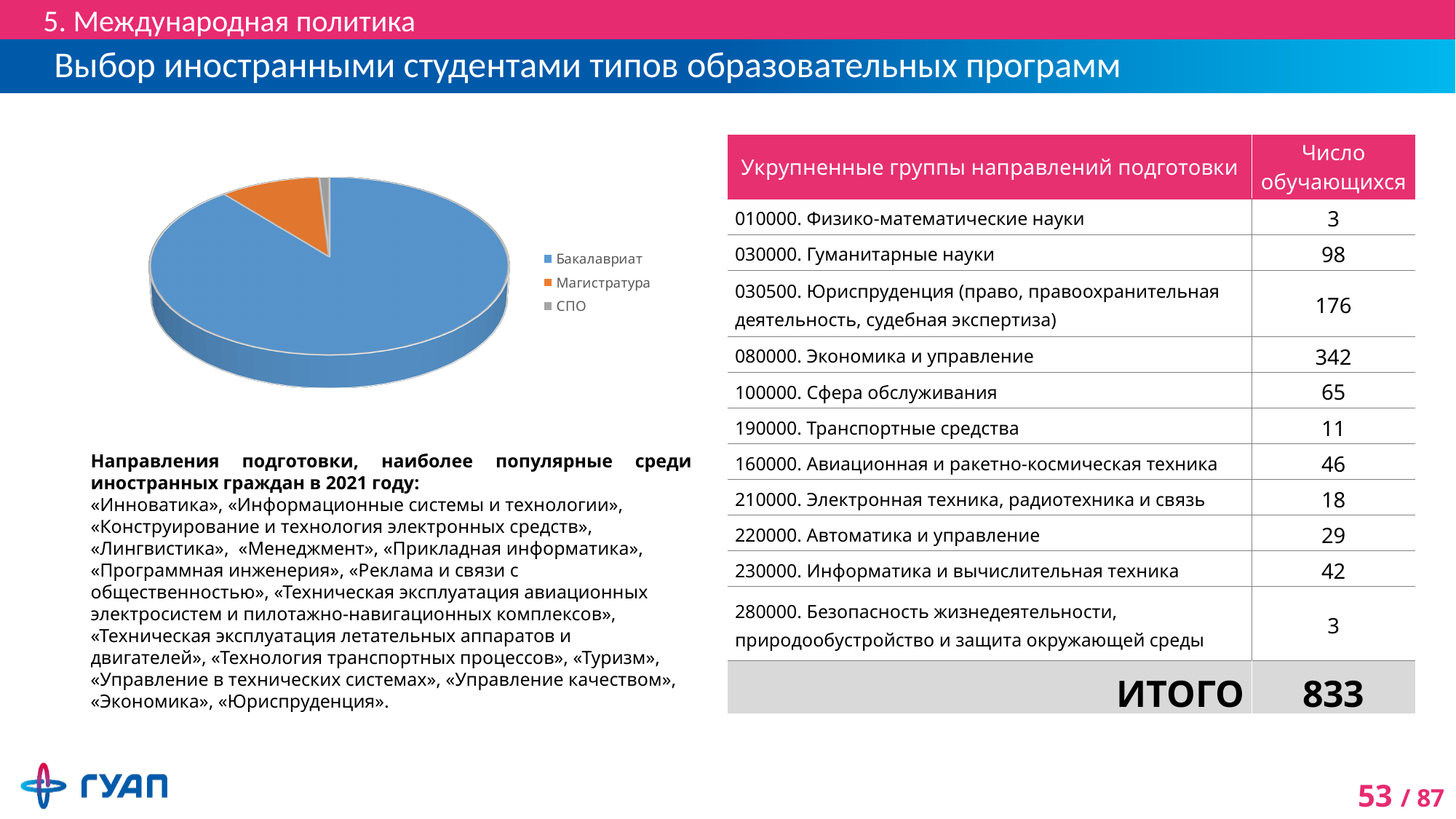
Which category has the largest slice in the pie chart? Бакалавриат Which legend entry in the pie chart is shown in orange? Магистратура In the pie chart, which slice is larger: Магистратура or СПО? Магистратура What kind of chart is shown on the slide? pie chart Which category has the smallest slice in the pie chart? СПО How many slices does the pie chart have? 3 In the pie chart, which slice is larger: Бакалавриат or Магистратура? Бакалавриат What colour is the Бакалавриат slice in the pie chart? blue How many entries does the pie chart's legend list? 3